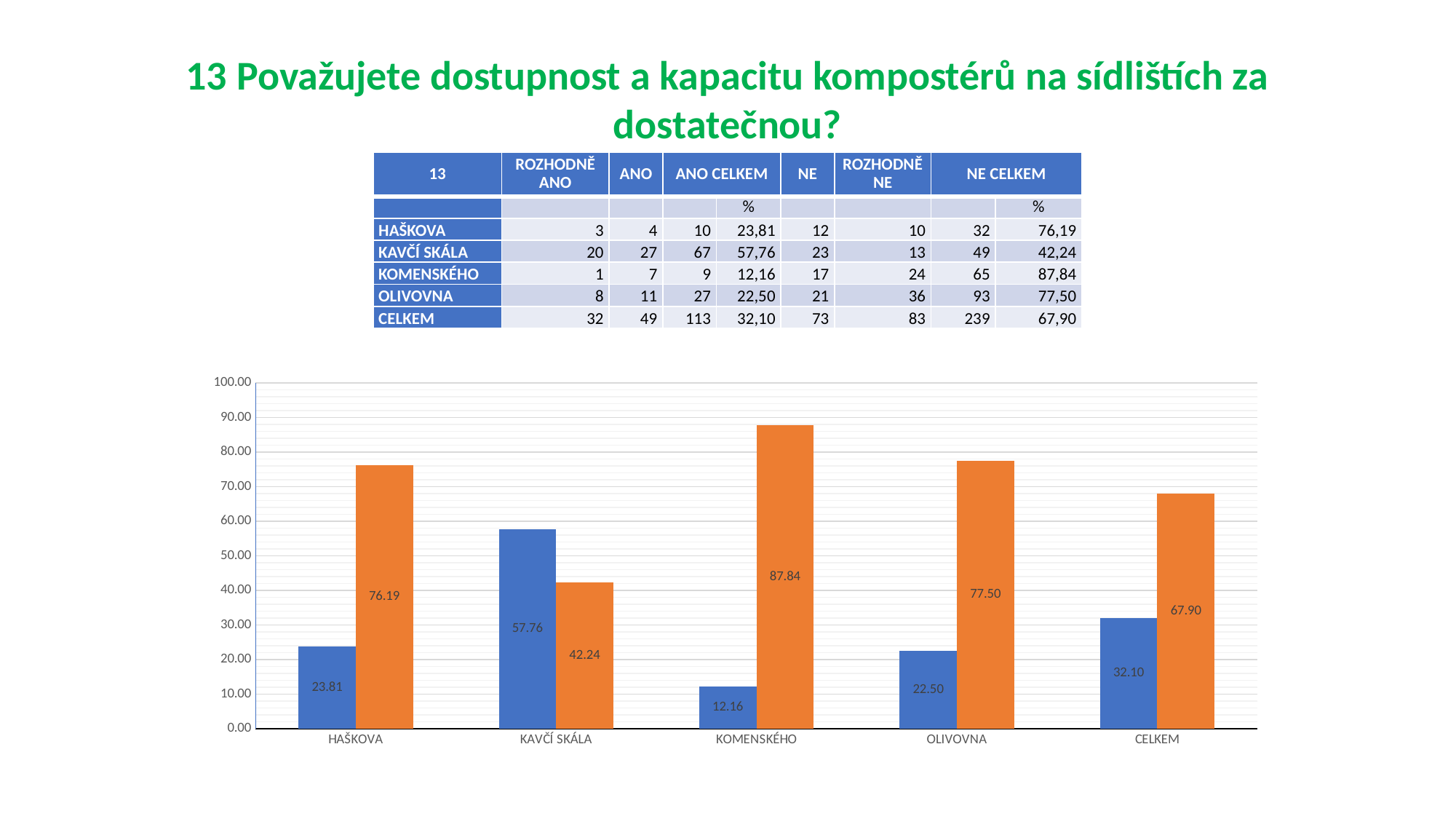
What is the value of the orange bar for CELKEM? 67.90 What is the value of the blue bar for KAVČÍ SKÁLA? 57.76 What is the maximum value shown on the y axis of the chart? 100.00 What is the value of the blue bar for HAŠKOVA? 23.81 Is the value of the orange bar for HAŠKOVA greater or less than 70.00? greater Which category has the highest orange bar? KOMENSKÉHO What is the value of the orange bar for KOMENSKÉHO? 87.84 What type of chart is shown on the slide? bar chart Which is larger for KAVČÍ SKÁLA, the blue bar or the orange bar? the blue bar What is the difference between the orange and blue bars for OLIVOVNA? 55.00 How many categories are shown on the x axis of the chart? 5 Which category has the lowest blue bar? KOMENSKÉHO